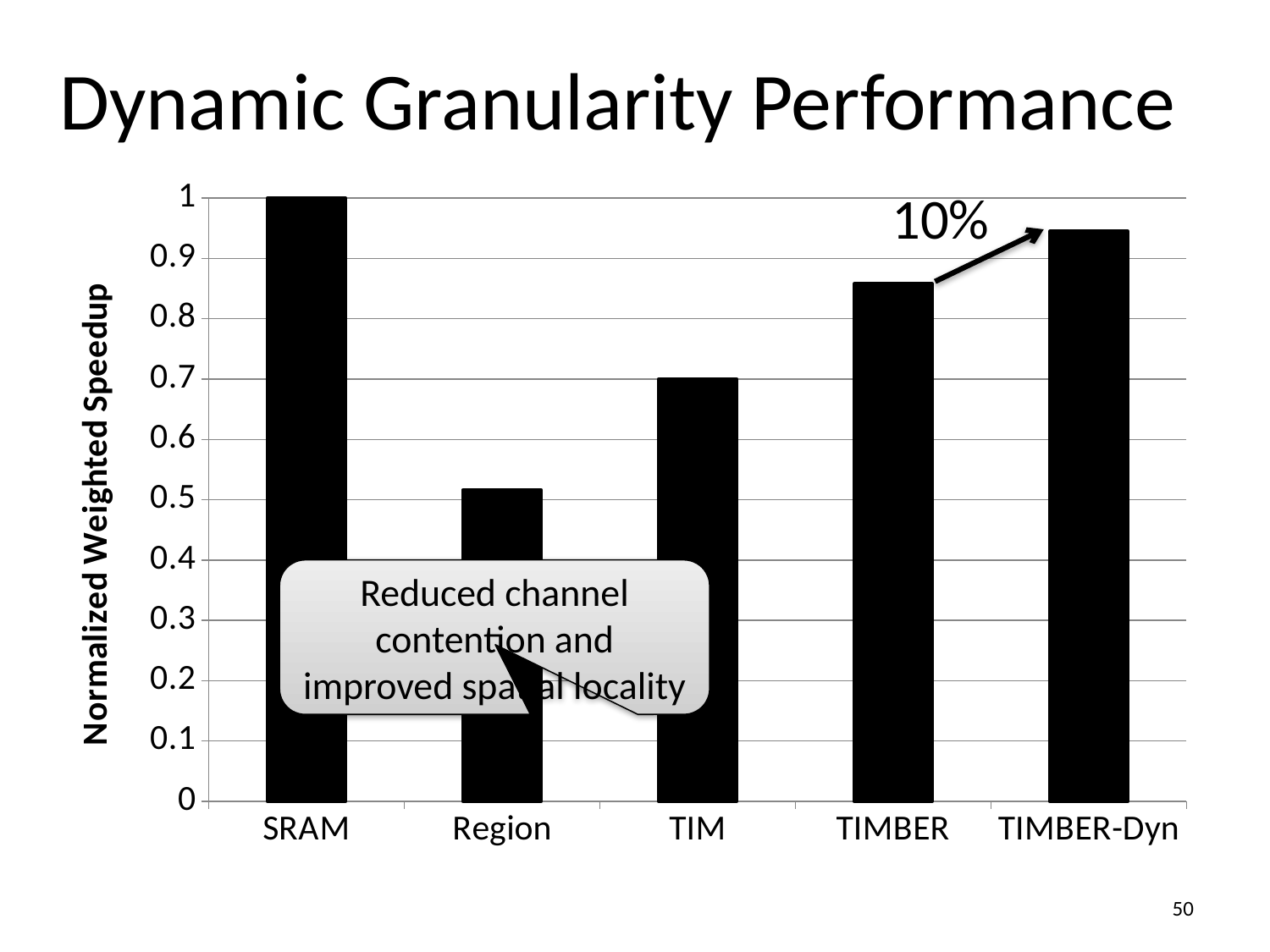
Is the value for TIMBER-Dyn greater or less than 0.9? greater Which category has the lowest normalized weighted speedup? Region What percentage improvement is annotated between TIMBER and TIMBER-Dyn? 10% What is the label of the y axis? Normalized Weighted Speedup What kind of chart is shown on the slide? bar chart Which has a larger normalized weighted speedup, TIMBER or TIMBER-Dyn? TIMBER-Dyn Which has a larger normalized weighted speedup, Region or TIM? TIM What is the normalized weighted speedup for SRAM? 1 Is the value for Region greater or less than 0.6? less How many categories are plotted on the x axis? 5 Is the value for TIMBER greater or less than 0.8? greater Which category has the highest normalized weighted speedup? SRAM